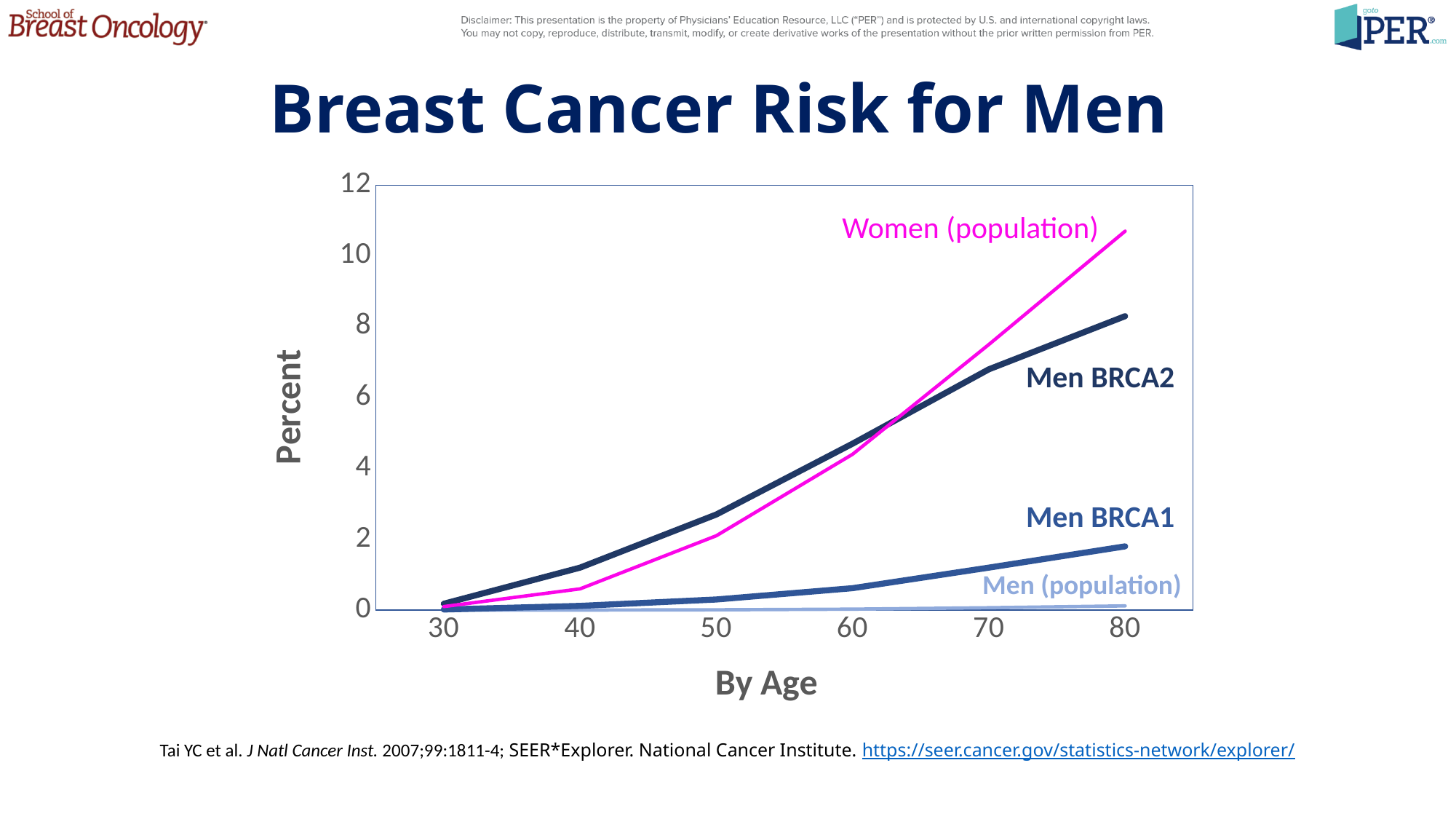
How many series are labelled on the chart? 4 At age 40, which is higher: Men BRCA2 or Women (population)? Men BRCA2 Does the Men BRCA2 line rise or fall as age increases from 30 to 80? rise What is the label on the y axis of the chart? Percent At age 80, which is higher: Women (population) or Men BRCA2? Women (population) Which series has the highest value at age 80? Women (population) Is the value for Women (population) at age 80 greater or less than 10? greater What kind of chart is shown on the slide? line chart How many age values are marked on the x axis? 6 Which series has the lowest value at age 80? Men (population) Is the value for Men BRCA1 at age 80 greater or less than 2? less Is the value for Men BRCA2 at age 50 greater or less than 2? greater